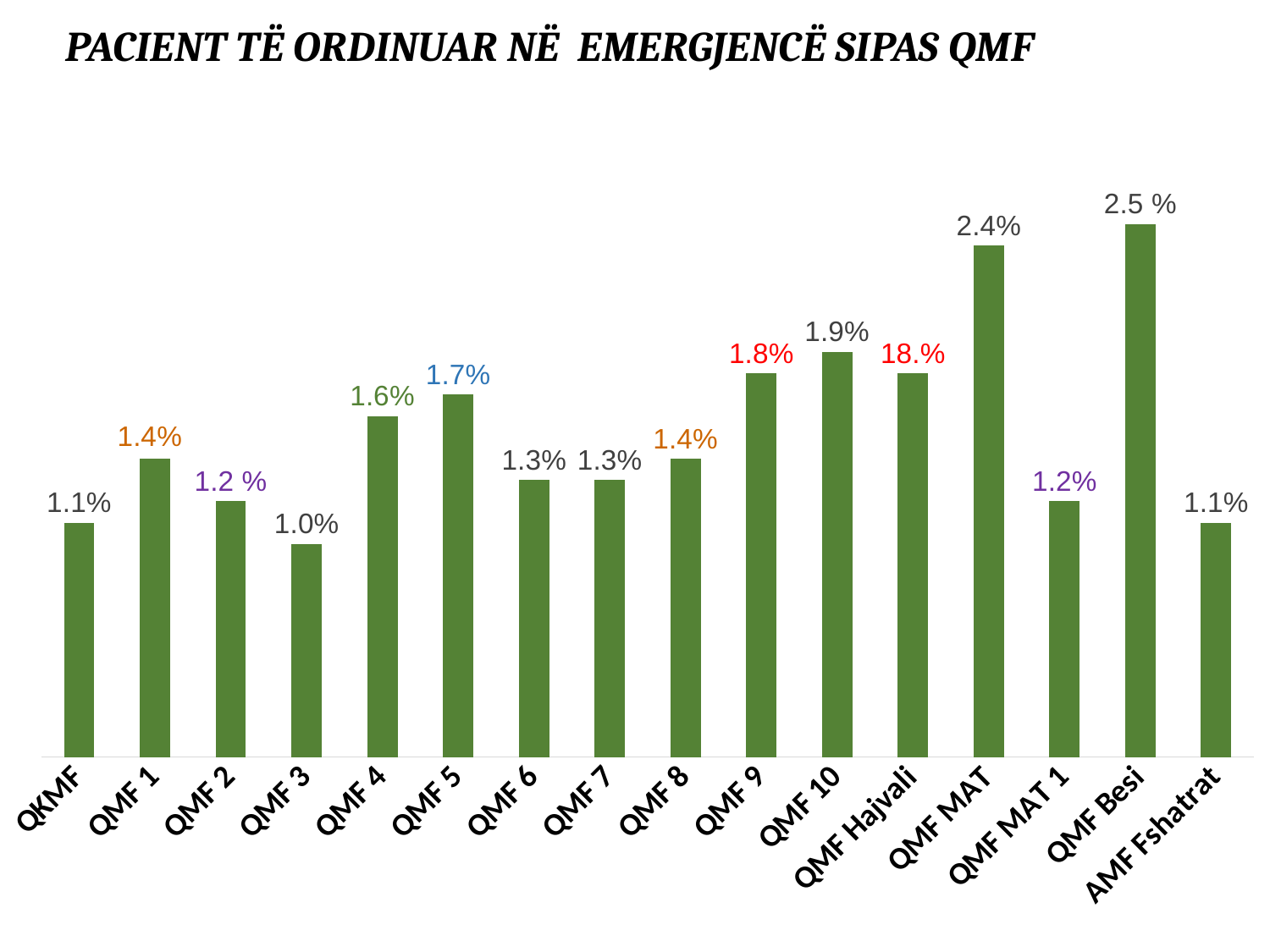
What is the value for QMF 3? 1.0% What is the value for QMF 5? 1.7% Which category has the lowest value? QMF 3 How many categories are shown on the x axis? 16 What is the value for AMF Fshatrat? 1.1% What kind of chart is this? bar chart What colour are the bars? green What is the title of the chart? PACIENT TË ORDINUAR NË EMERGJENCË SIPAS QMF What is the difference between the values for QMF MAT and QMF 10? 0.5% Which category has the highest value? QMF Besi Which is larger, the value for QMF 4 or the value for QMF 8? QMF 4 What is the value for QMF MAT? 2.4%